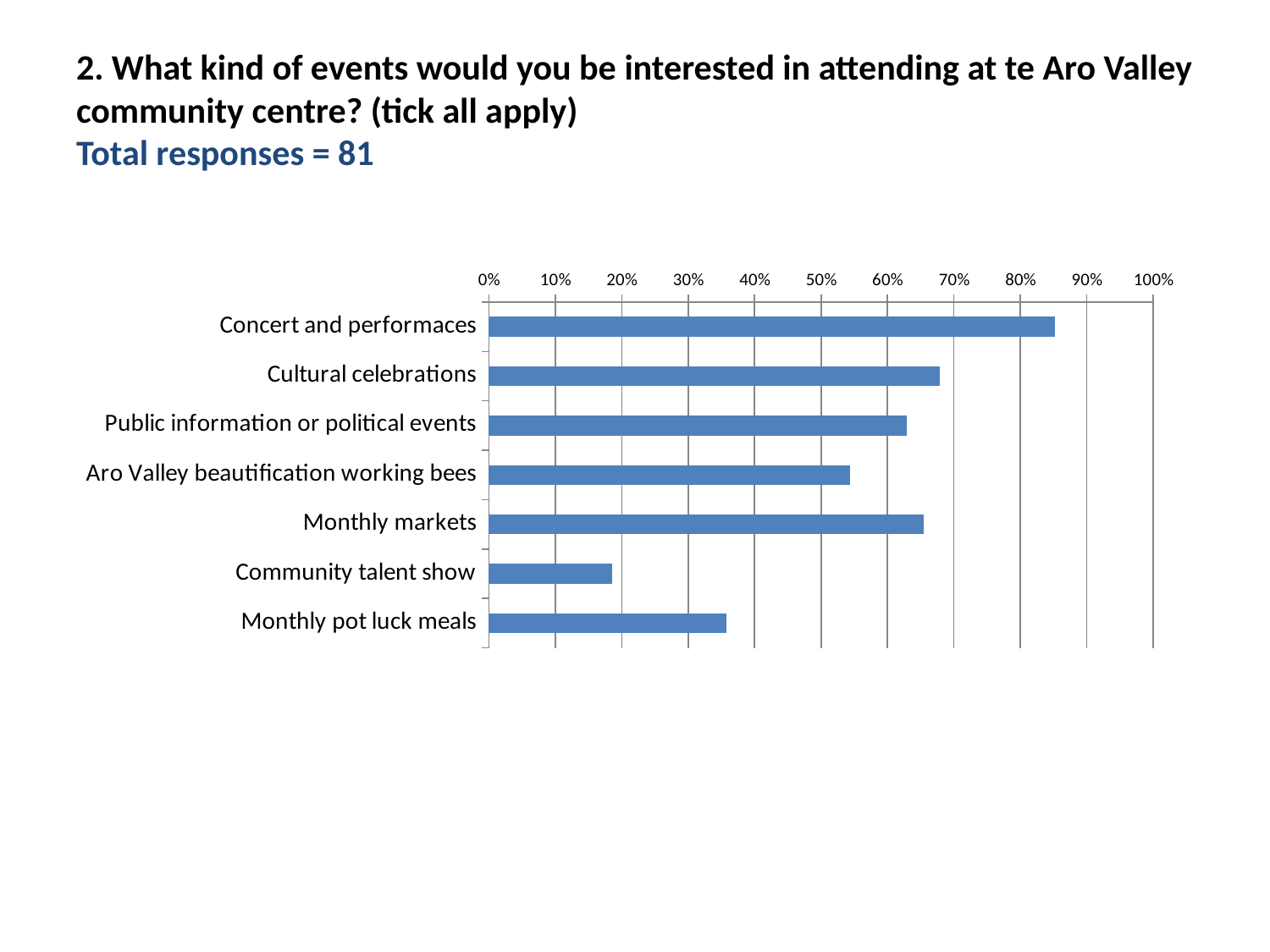
Which event category has the lowest value? Community talent show Is the value for Community talent show greater or less than 20%? less Is the value for Cultural celebrations greater or less than 70%? less According to the slide, what is the total number of responses? 81 Is the value for Concert and performaces greater or less than 80%? greater How many event categories are shown in the chart? 7 What type of chart is shown on the slide? bar chart Which is larger, the value for Monthly pot luck meals or the value for Community talent show? Monthly pot luck meals Which is larger, the value for Concert and performaces or the value for Cultural celebrations? Concert and performaces Which event category has the highest value? Concert and performaces